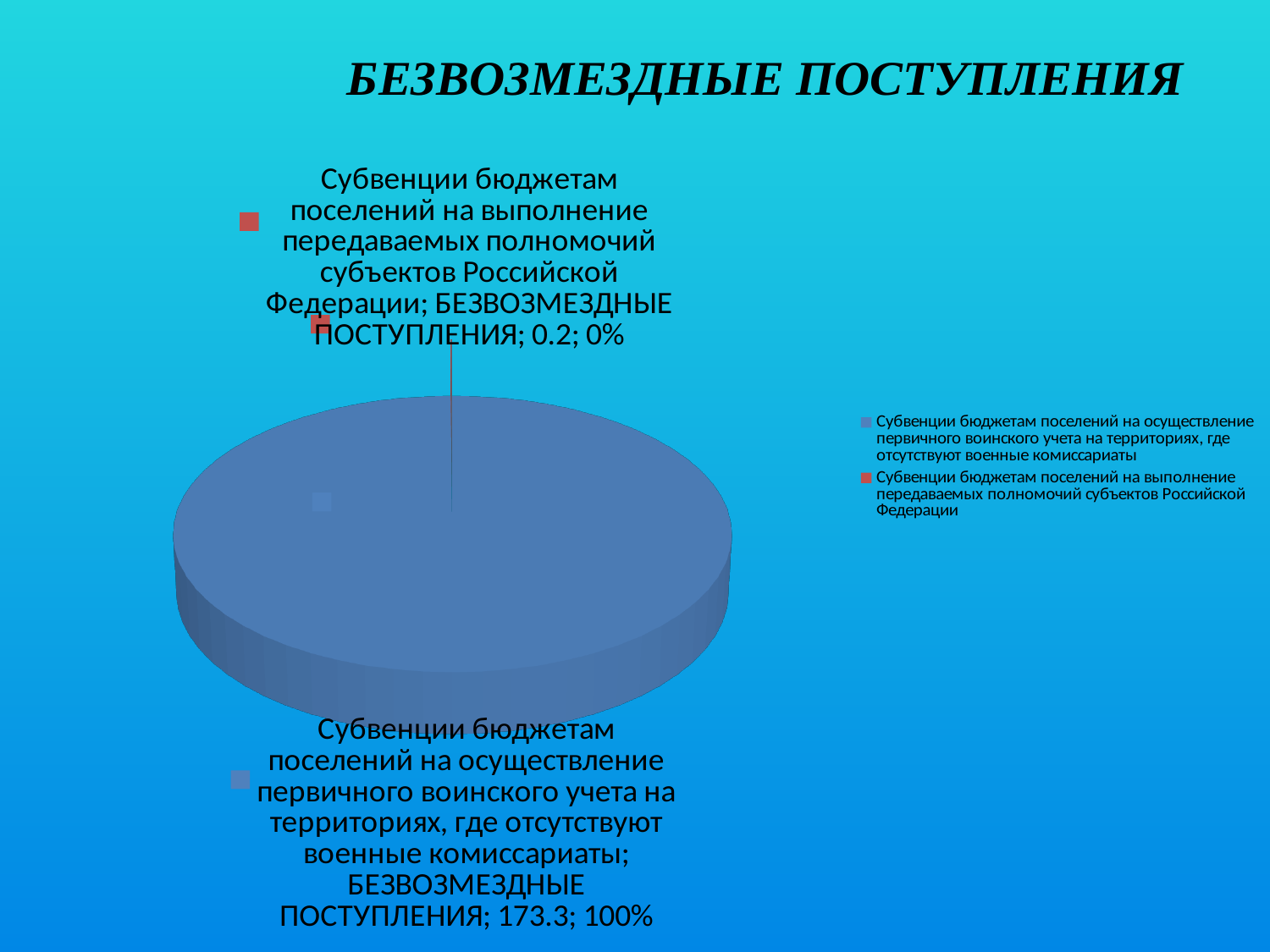
Which category has the smallest value in the pie chart? Субвенции бюджетам поселений на выполнение передаваемых полномочий субъектов Российской Федерации What is the value for 'Субвенции бюджетам поселений на выполнение передаваемых полномочий субъектов Российской Федерации'? 0.2 How many categories does the pie chart show? 2 What kind of chart is shown on the slide? Pie chart Which category has the largest value in the pie chart? Субвенции бюджетам поселений на осуществление первичного воинского учета на территориях, где отсутствуют военные комиссариаты What is the value for 'Субвенции бюджетам поселений на осуществление первичного воинского учета на территориях, где отсутствуют военные комиссариаты'? 173.3 What share of the pie does 'Субвенции бюджетам поселений на осуществление первичного воинского учета на территориях, где отсутствуют военные комиссариаты' represent? 100% What is the difference between the values for 'Субвенции бюджетам поселений на осуществление первичного воинского учета...' and 'Субвенции бюджетам поселений на выполнение передаваемых полномочий...'? 173.1 How many entries does the legend list? 2 What share of the pie does 'Субвенции бюджетам поселений на выполнение передаваемых полномочий субъектов Российской Федерации' represent? 0% Which legend entry is shown in red? Субвенции бюджетам поселений на выполнение передаваемых полномочий субъектов Российской Федерации What is the title of the chart on the slide? БЕЗВОЗМЕЗДНЫЕ ПОСТУПЛЕНИЯ